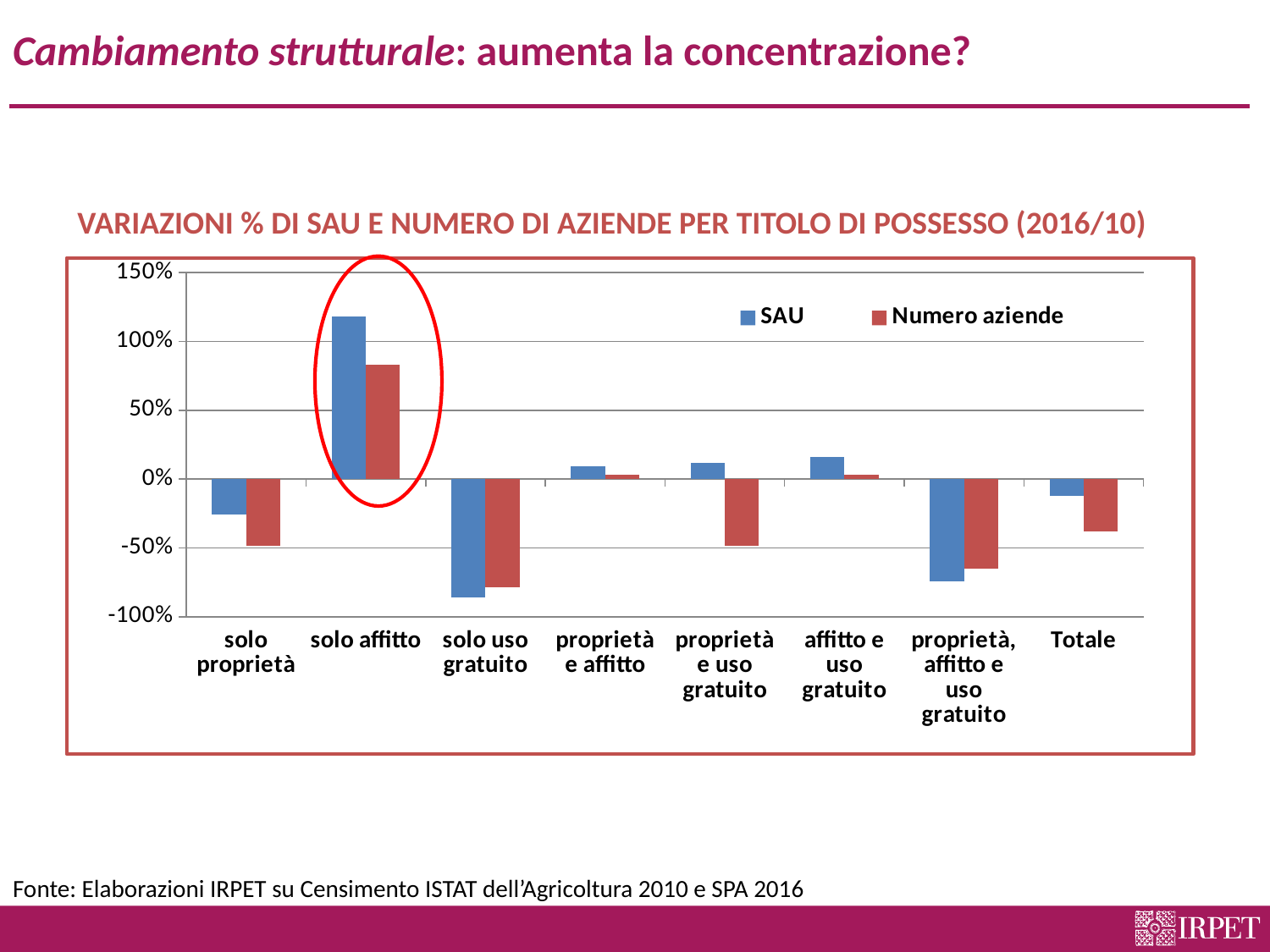
Which category has the lowest Numero aziende value? solo uso gratuito Which category has the highest Numero aziende value? solo affitto Which category has the highest SAU value? solo affitto What are the two series named in the legend? SAU and Numero aziende Is the SAU value for solo uso gratuito greater or less than -50%? less Which category has the lowest SAU value? solo uso gratuito Is the Numero aziende value for solo affitto greater or less than 100%? less How many categories are shown on the x axis? 8 How many series does the legend list? 2 What kind of chart is shown on the slide? bar chart Is the SAU value for solo affitto greater or less than 100%? greater For solo affitto, which is larger: SAU or Numero aziende? SAU